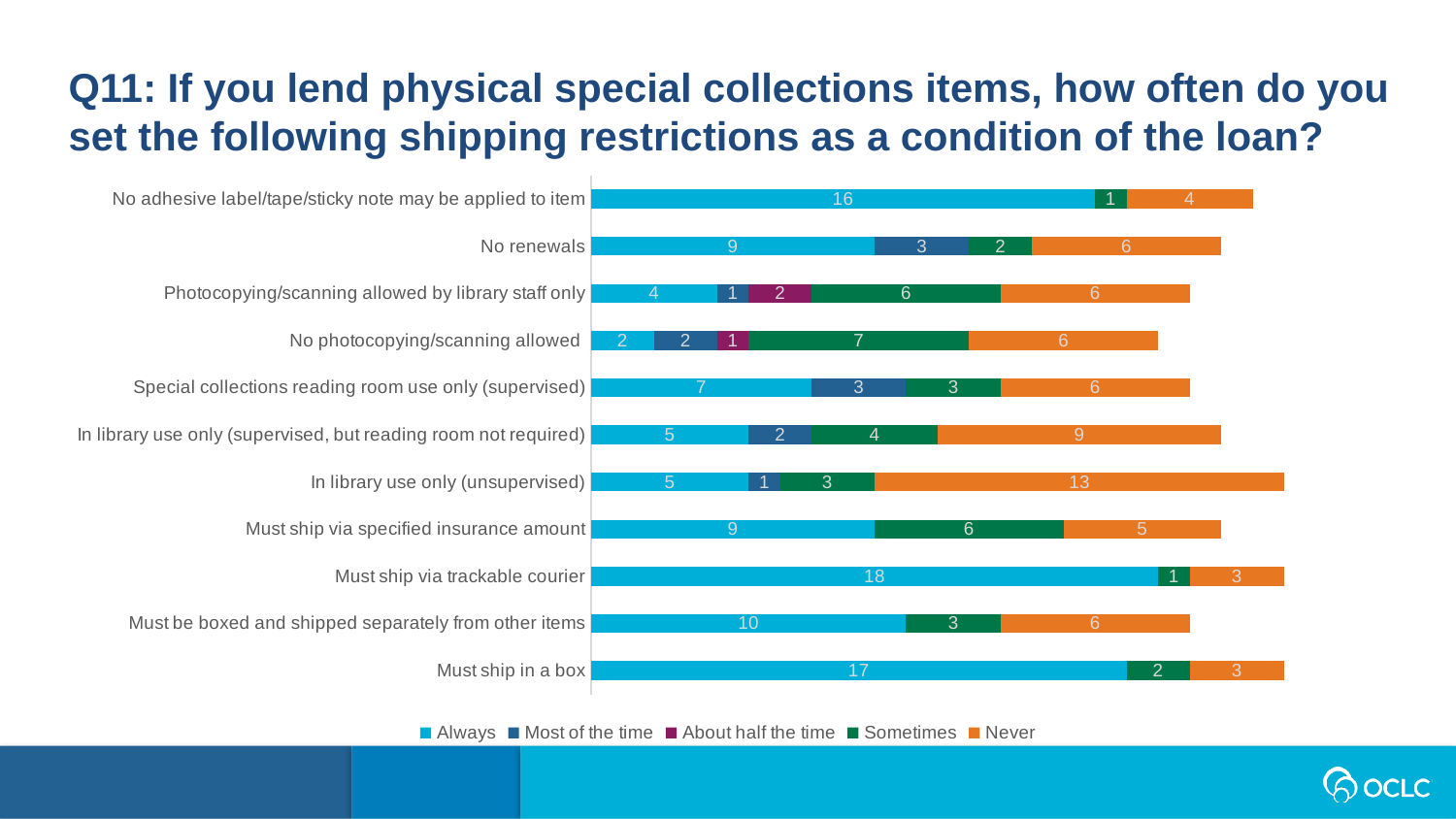
How many respondents answered "Always" for "Must ship via trackable courier"? 18 Which legend entry is shown in orange? Never Which shipping restriction has the highest "Always" value? Must ship via trackable courier How many shipping restriction categories are shown in the chart? 11 What kind of chart is shown on the slide? Stacked bar chart What is the "Never" value for "In library use only (unsupervised)"? 13 Which shipping restriction has the lowest "Always" value? No photocopying/scanning allowed What is the difference between the "Always" values for "Must ship in a box" and "No renewals"? 8 What is the total of the stacked bar for "No renewals"? 20 Which has a larger "Never" value: "In library use only (unsupervised)" or "No renewals"? In library use only (unsupervised) What is the "Sometimes" value for "No photocopying/scanning allowed"? 7 How many series does the legend list? 5